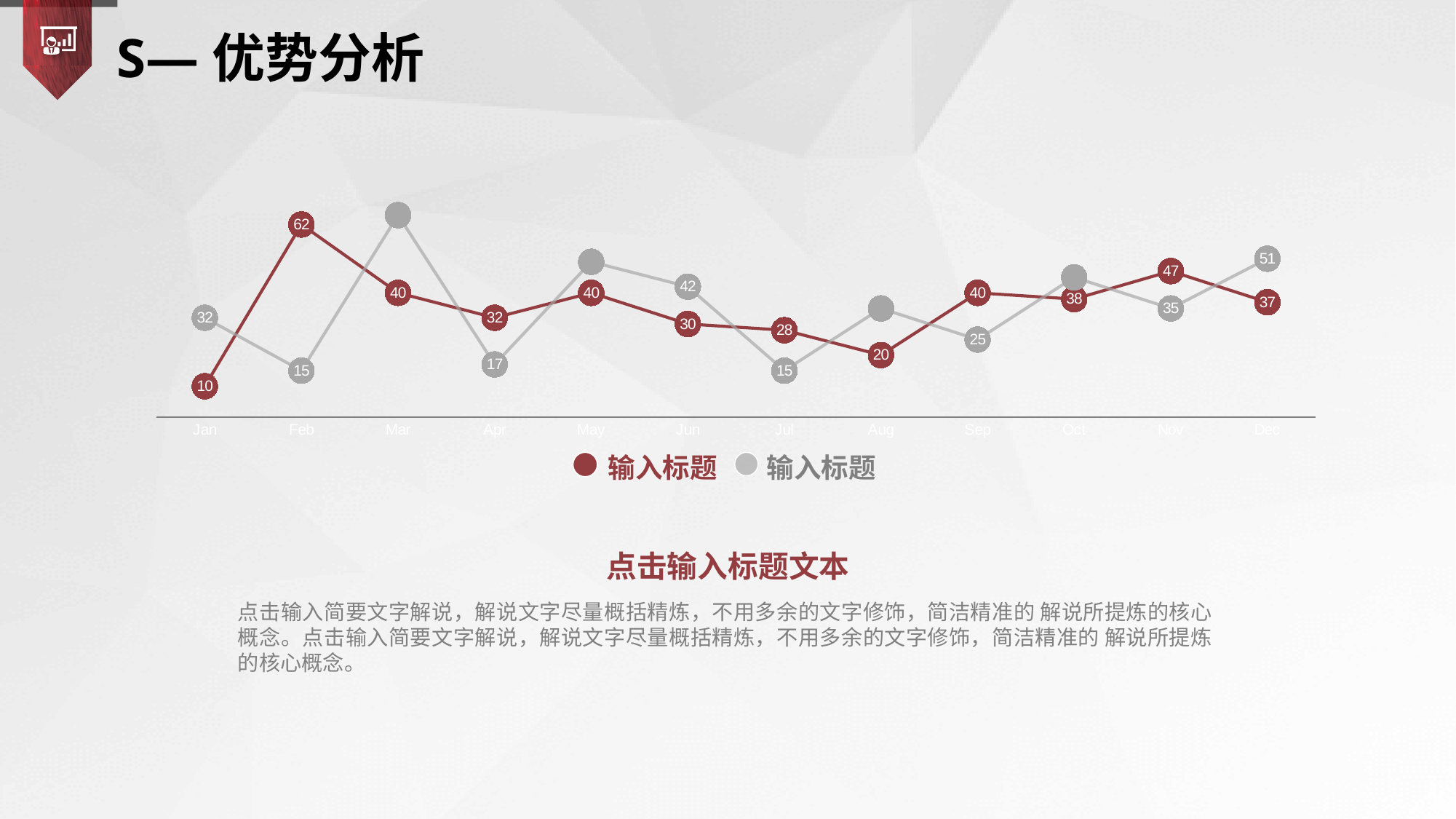
What is the value of the red series in Aug? 20 What type of chart is shown on the slide? line chart In which month does the red series reach its highest value? Feb How many series does the legend list? 2 Which series has the larger value in Jan, the red series or the grey series? the grey series In which month does the red series have its lowest value? Jan What is the value of the red series in Feb? 62 What is the value of the grey series in Jun? 42 What is the value of the grey series in Dec? 51 Does the red series rise or fall from Sep to Nov? rise What is the difference between the red series values in Feb and Jan? 52 How many months are plotted along the x axis? 12